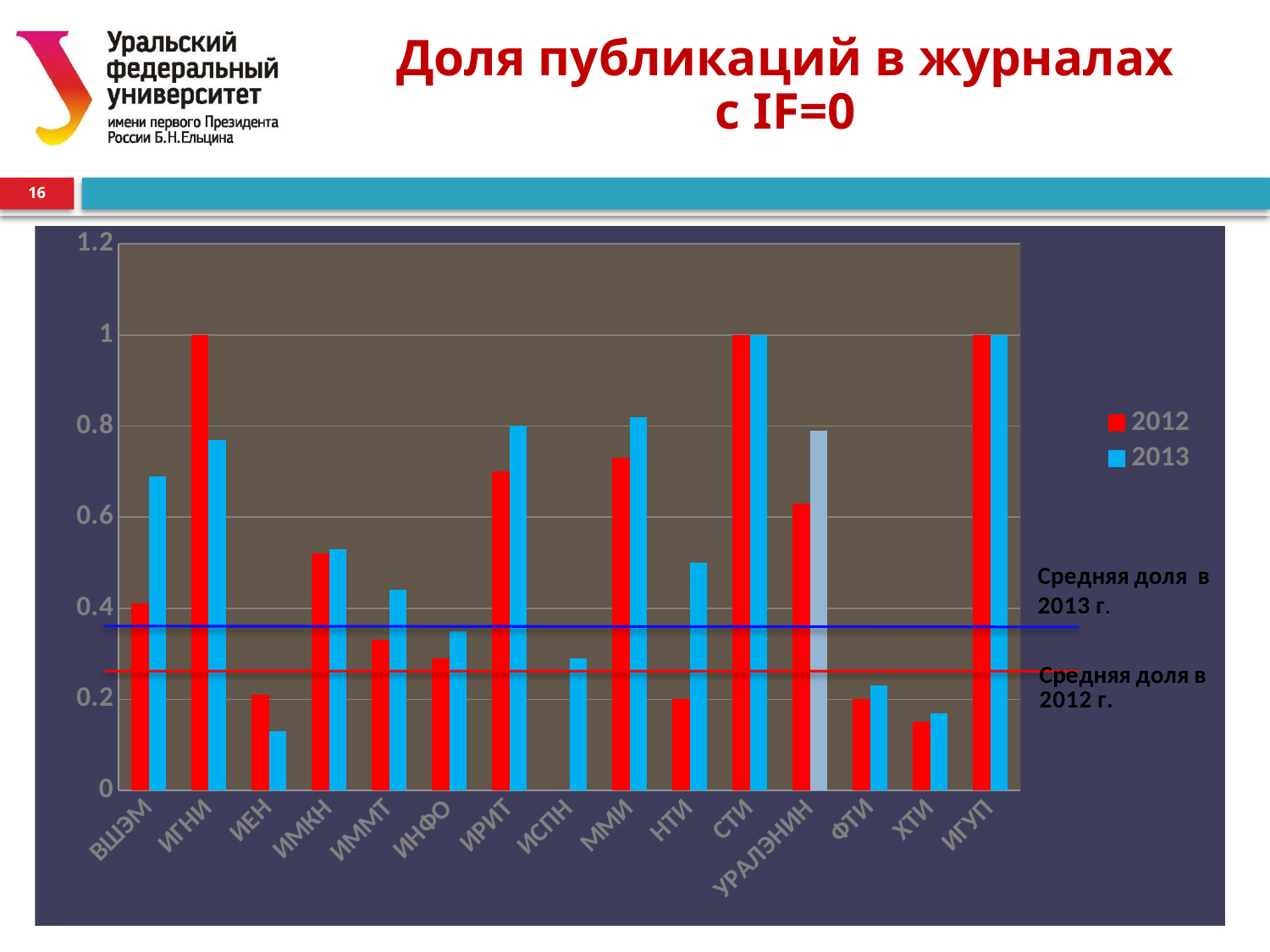
What is the value for ИГУП in 2012? 1 Is the value for ИРИТ in 2013 greater or less than 0.6? greater What kind of chart is shown on the slide? bar chart What is the value for СТИ in 2013? 1 How many categories (institutes) are shown on the x axis? 15 Which is larger for ИГНИ: the 2012 value or the 2013 value? 2012 Is the value for ИЕН in 2013 greater or less than 0.2? less How many series does the legend list? 2 Is the value for ВШЭМ in 2013 greater or less than 0.6? greater What is the value for ИГНИ in 2012? 1 Which colour represents the 2013 series in the legend? blue Which is larger for ВШЭМ: the 2012 value or the 2013 value? 2013